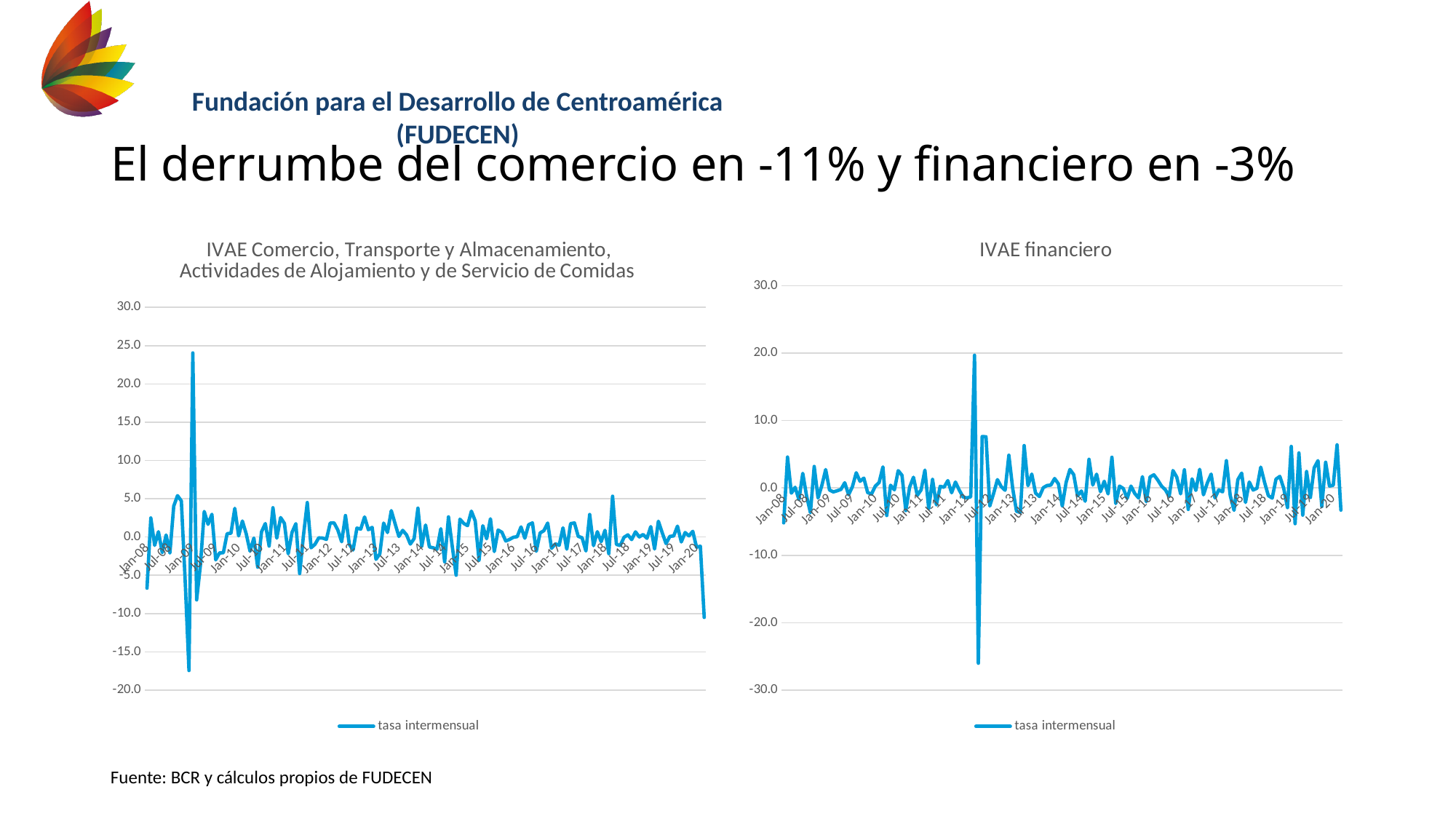
What is the legend entry shown under the left chart? tasa intermensual In the left chart (IVAE Comercio, Transporte y Almacenamiento...), is the lowest point of the line greater or less than -15.0? less What is the title of the chart on the right of the slide? IVAE financiero In the left chart (IVAE Comercio, Transporte y Almacenamiento...), is the highest peak of the line greater or less than 20.0? greater How many series does the legend of the 'IVAE financiero' chart list? 1 What is the lowest value shown on the vertical axis of the 'IVAE financiero' chart? -30.0 What kind of chart is the 'IVAE Comercio, Transporte y Almacenamiento, Actividades de Alojamiento y de Servicio de Comidas' chart? line chart What kind of chart is the 'IVAE financiero' chart? line chart In the 'IVAE financiero' chart, is the highest peak of the line greater or less than 10.0? greater In the 'IVAE financiero' chart, which is larger: the highest peak near Jan-12 or the peak near Jan-08? the peak near Jan-12